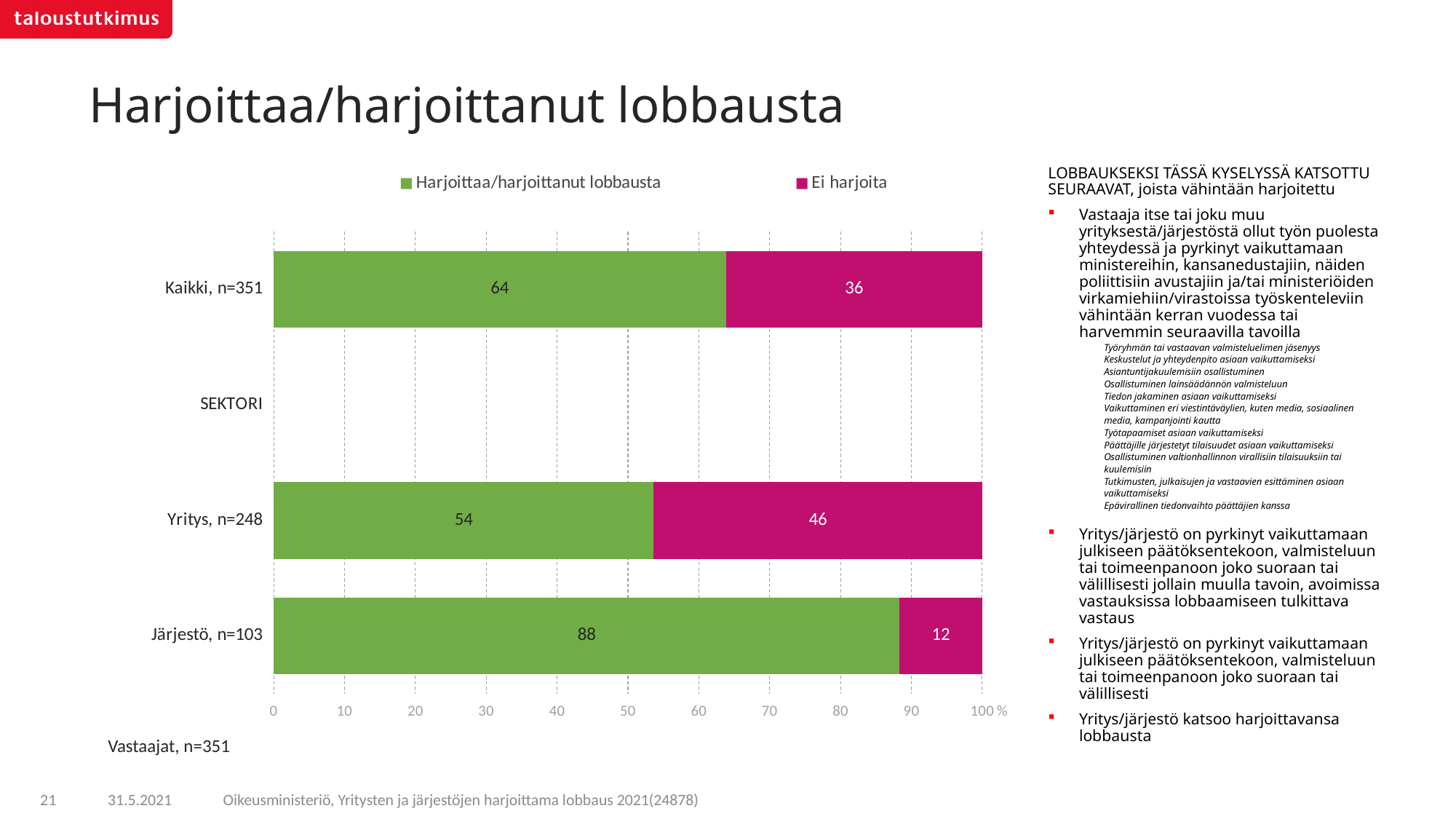
What kind of chart is shown on the slide? Stacked bar chart Which colour represents Ei harjoita in the chart? Magenta Which is larger: the Ei harjoita value for Kaikki, n=351 or for Yritys, n=248? Yritys, n=248 What is the difference between the Harjoittaa/harjoittanut lobbausta values for Järjestö, n=103 and Yritys, n=248? 34 Which group has the highest Harjoittaa/harjoittanut lobbausta value? Järjestö, n=103 What is the Ei harjoita value for Järjestö, n=103? 12 What percentage of Kaikki, n=351 respondents Harjoittaa/harjoittanut lobbausta? 64 What is the Ei harjoita value for Yritys, n=248? 46 Which group has the lowest Harjoittaa/harjoittanut lobbausta value? Yritys, n=248 What is the Harjoittaa/harjoittanut lobbausta value for Järjestö, n=103? 88 What is the total of the stacked bar for Yritys, n=248? 100 How many series does the legend list? 2